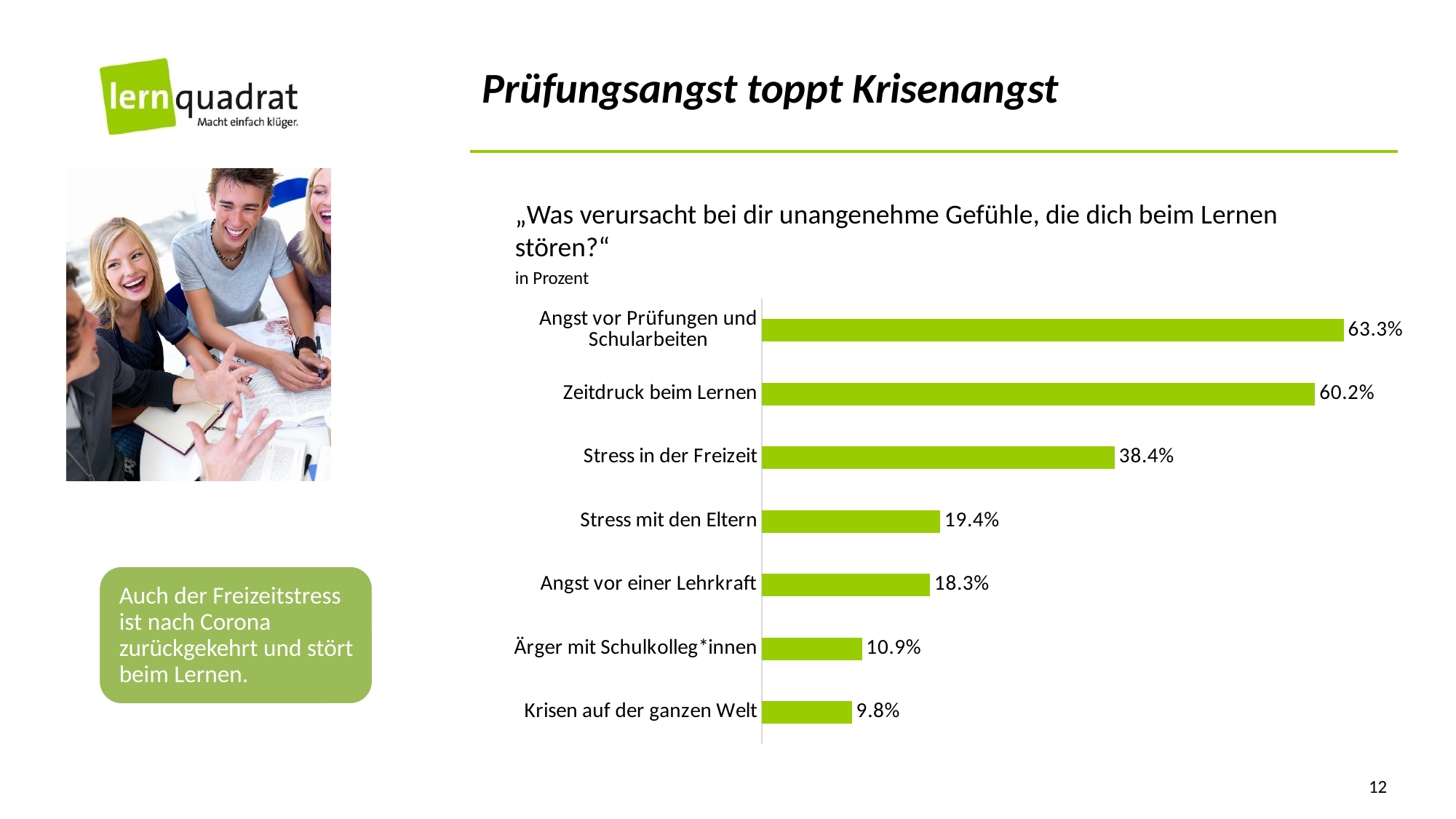
Which category has the lowest value? Krisen auf der ganzen Welt Which is larger, "Ärger mit Schulkolleg*innen" or "Krisen auf der ganzen Welt"? Ärger mit Schulkolleg*innen What kind of chart is shown on the slide? Bar chart What is the value for "Stress mit den Eltern"? 19.4% What is the difference between "Angst vor Prüfungen und Schularbeiten" and "Zeitdruck beim Lernen"? 3.1% What unit are the chart values given in, according to the note under the question? in Prozent How many categories are shown in the chart? 7 Which is larger, "Stress mit den Eltern" or "Angst vor einer Lehrkraft"? Stress mit den Eltern Which category has the highest value? Angst vor Prüfungen und Schularbeiten What is the difference between "Stress in der Freizeit" and "Stress mit den Eltern"? 19.0% What is the value for "Krisen auf der ganzen Welt"? 9.8% What is the value for "Zeitdruck beim Lernen"? 60.2%